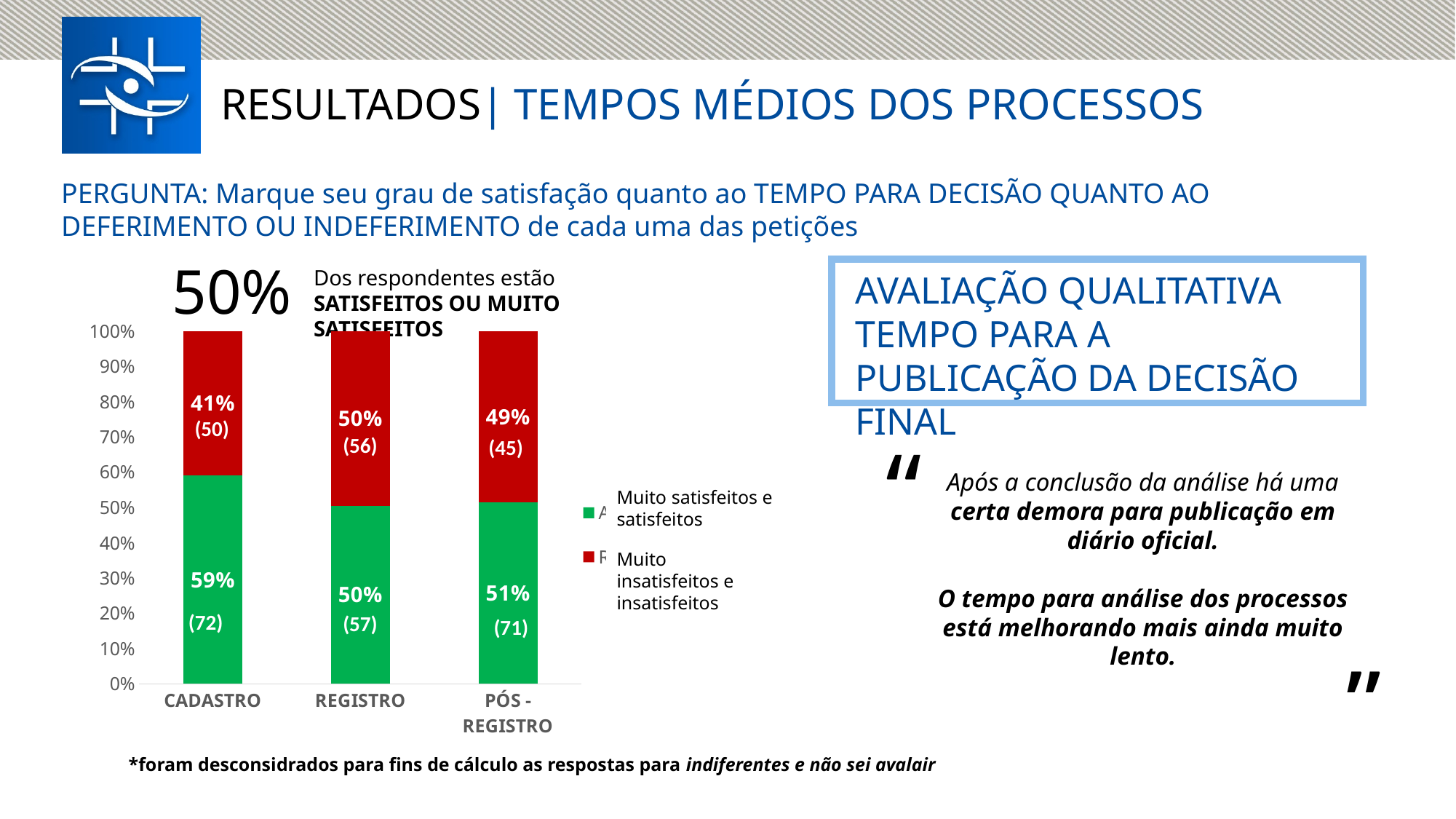
What percentage of respondents for REGISTRO are 'Muito insatisfeitos e insatisfeitos'? 50% Which category has the lowest share of 'Muito insatisfeitos e insatisfeitos' respondents? CADASTRO Is the 'Muito satisfeitos e satisfeitos' share larger for CADASTRO or for PÓS - REGISTRO? CADASTRO How many respondents are counted as 'Muito insatisfeitos e insatisfeitos' for PÓS - REGISTRO, as shown in parentheses? 45 What percentage of respondents for CADASTRO are 'Muito satisfeitos e satisfeitos'? 59% Which colour represents 'Muito insatisfeitos e insatisfeitos' in the chart? Red How many series does the chart's legend list? 2 Which category has the highest share of 'Muito satisfeitos e satisfeitos' respondents? CADASTRO What kind of chart is shown on the slide? Stacked bar chart How many categories are shown on the x axis of the chart? 3 What is the difference between the 'Muito satisfeitos e satisfeitos' percentage for CADASTRO and for REGISTRO? 9% What percentage of respondents for PÓS - REGISTRO are 'Muito satisfeitos e satisfeitos'? 51%